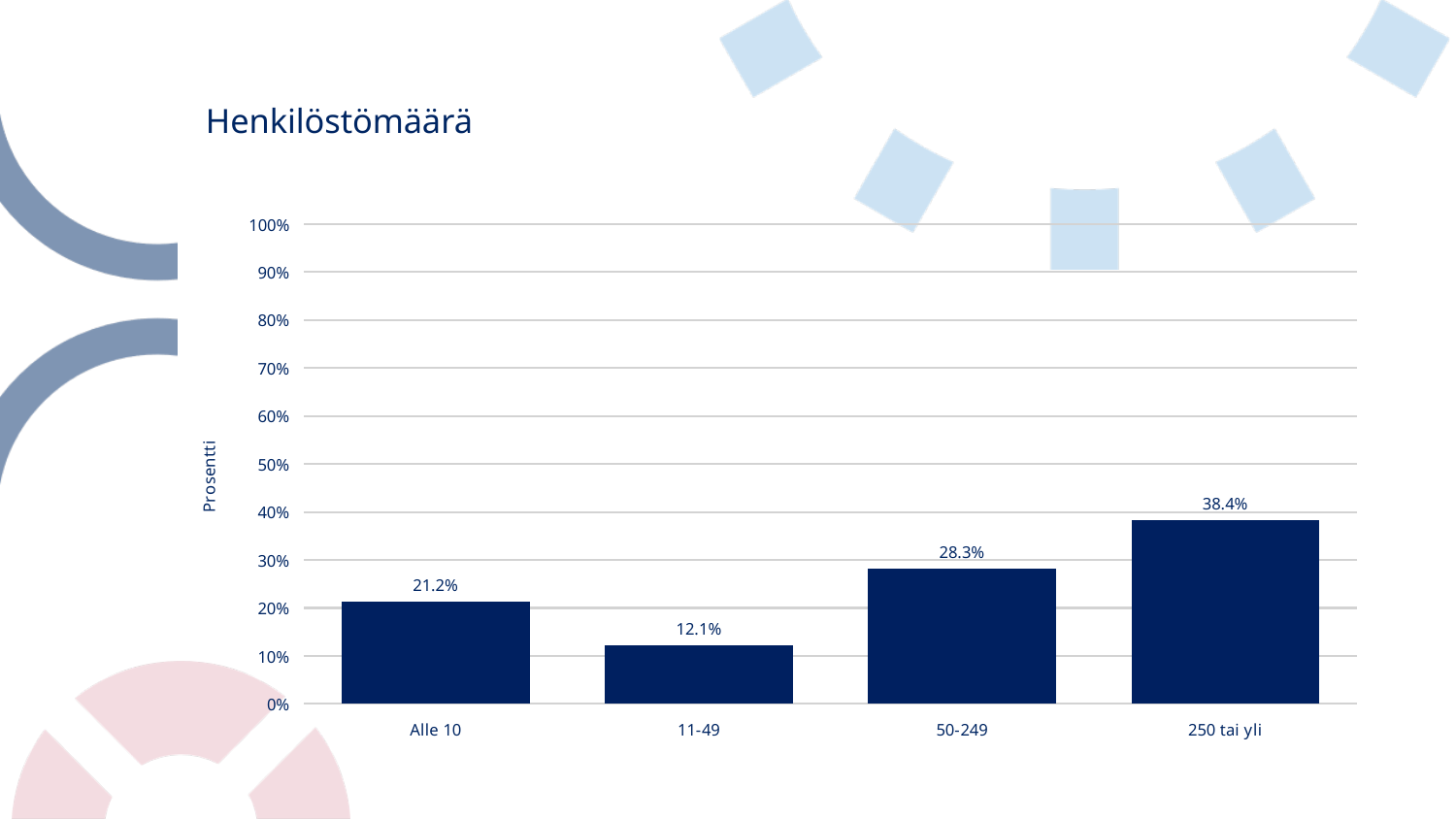
Which category has the lowest value? 11-49 How many categories are shown on the x axis? 4 What is the value for the '50-249' category? 28.3% What is the difference between the values for '250 tai yli' and '11-49'? 26.3% Which is larger, the value for 'Alle 10' or the value for '50-249'? 50-249 What is the value for the 'Alle 10' category? 21.2% What kind of chart is shown on the slide? Bar chart Which category has the highest value? 250 tai yli What is the title of the chart? Henkilöstömäärä What is the value for the '250 tai yli' category? 38.4% Is the value for '250 tai yli' greater or less than 30%? greater What is the value for the '11-49' category? 12.1%